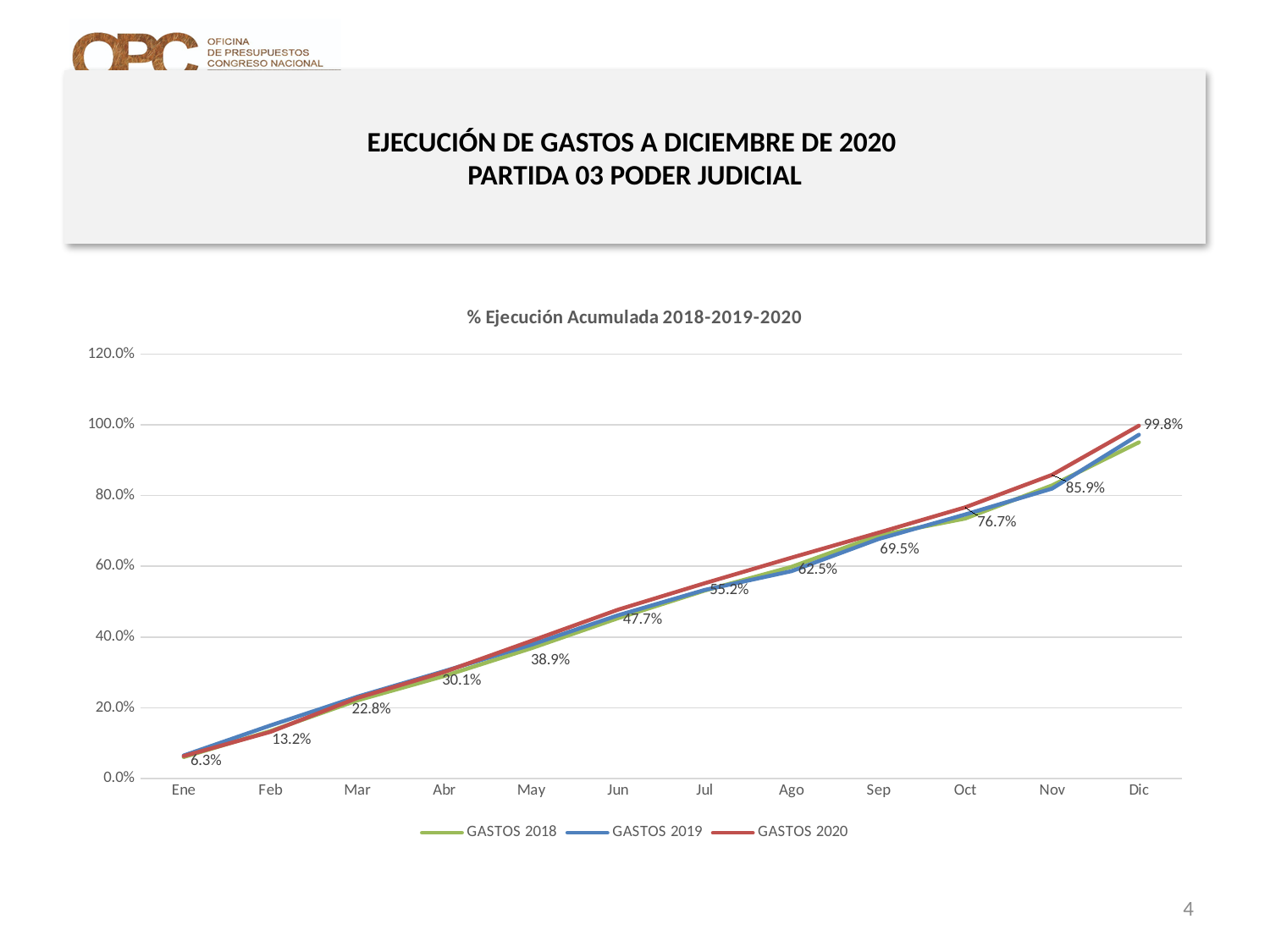
What is the value for GASTOS 2020 in Dic? 99.8% Do the values rise or fall from Ene to Dic? Rise What kind of chart is shown? Line chart In which month is the GASTOS 2020 value highest? Dic What is the value for GASTOS 2020 in Jun? 47.7% How many series does the legend list? 3 What is the value for GASTOS 2020 in Ene? 6.3% How many months are shown on the x axis? 12 Is the value for GASTOS 2018 in Dic greater or less than 100.0%? less What is the difference between the GASTOS 2020 values for Dic and Nov? 13.9% What is the value for GASTOS 2020 in Oct? 76.7% In which month is the GASTOS 2020 value lowest? Ene